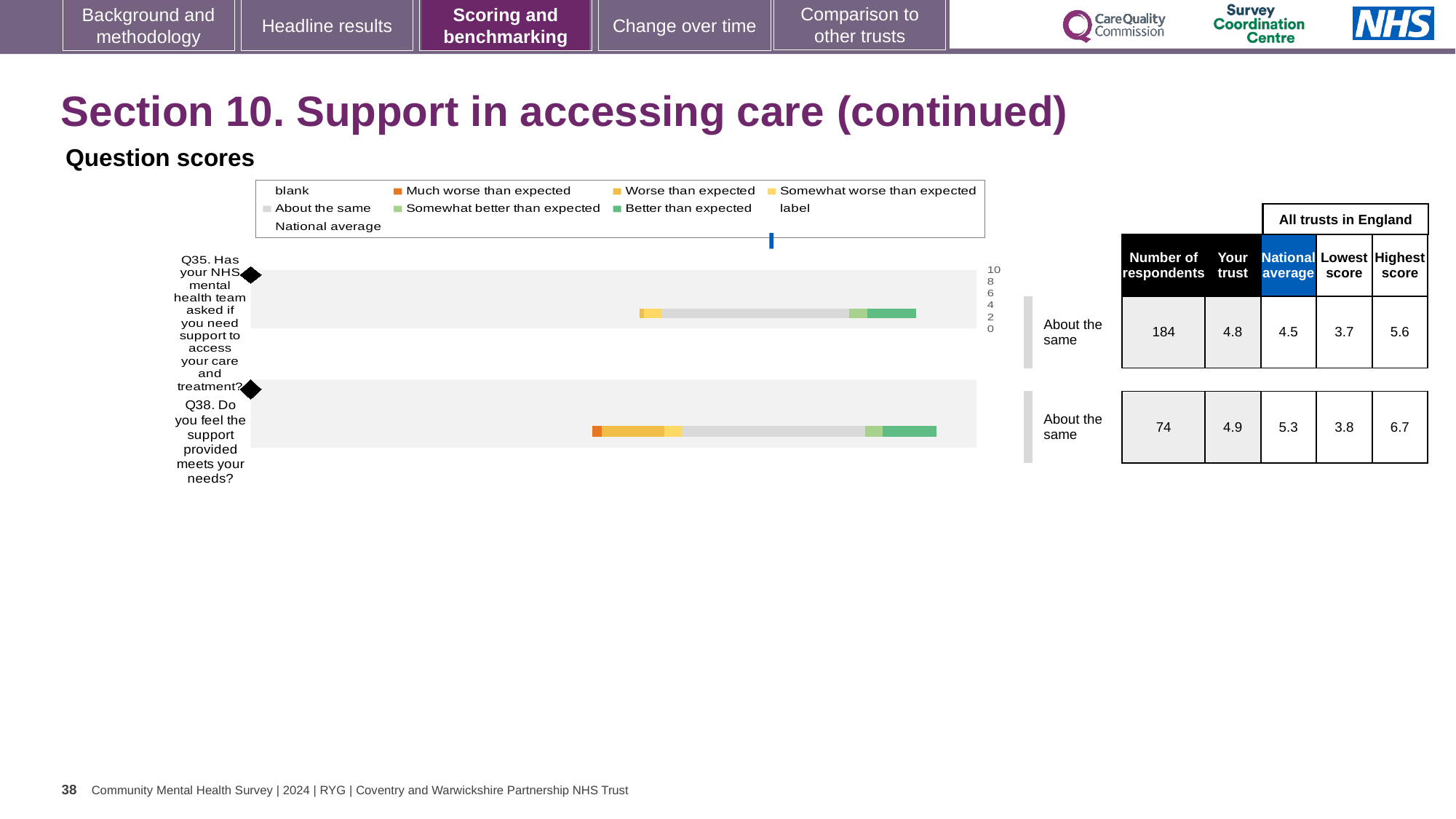
Which question has the higher national average, Q35 or Q38? Q38 What is the lowest score among all trusts in England for Q35? 3.7 What is the 'Your trust' score for Q35 (Has your NHS mental health team asked if you need support to access your care and treatment?)? 4.8 What benchmark category is shown for Q38 in the question scores chart? About the same How many entries does the legend of the question scores chart list? 9 Which question has the higher 'Your trust' score, Q35 or Q38? Q38 How many questions are plotted in the question scores chart? 2 What is the difference between the highest and lowest scores for Q38? 2.9 What kind of chart is used to show the question scores on this slide? bar chart What is the national average score for Q38 (Do you feel the support provided meets your needs?)? 5.3 How many respondents answered Q35? 184 By how much does the trust's score for Q35 exceed the national average? 0.3